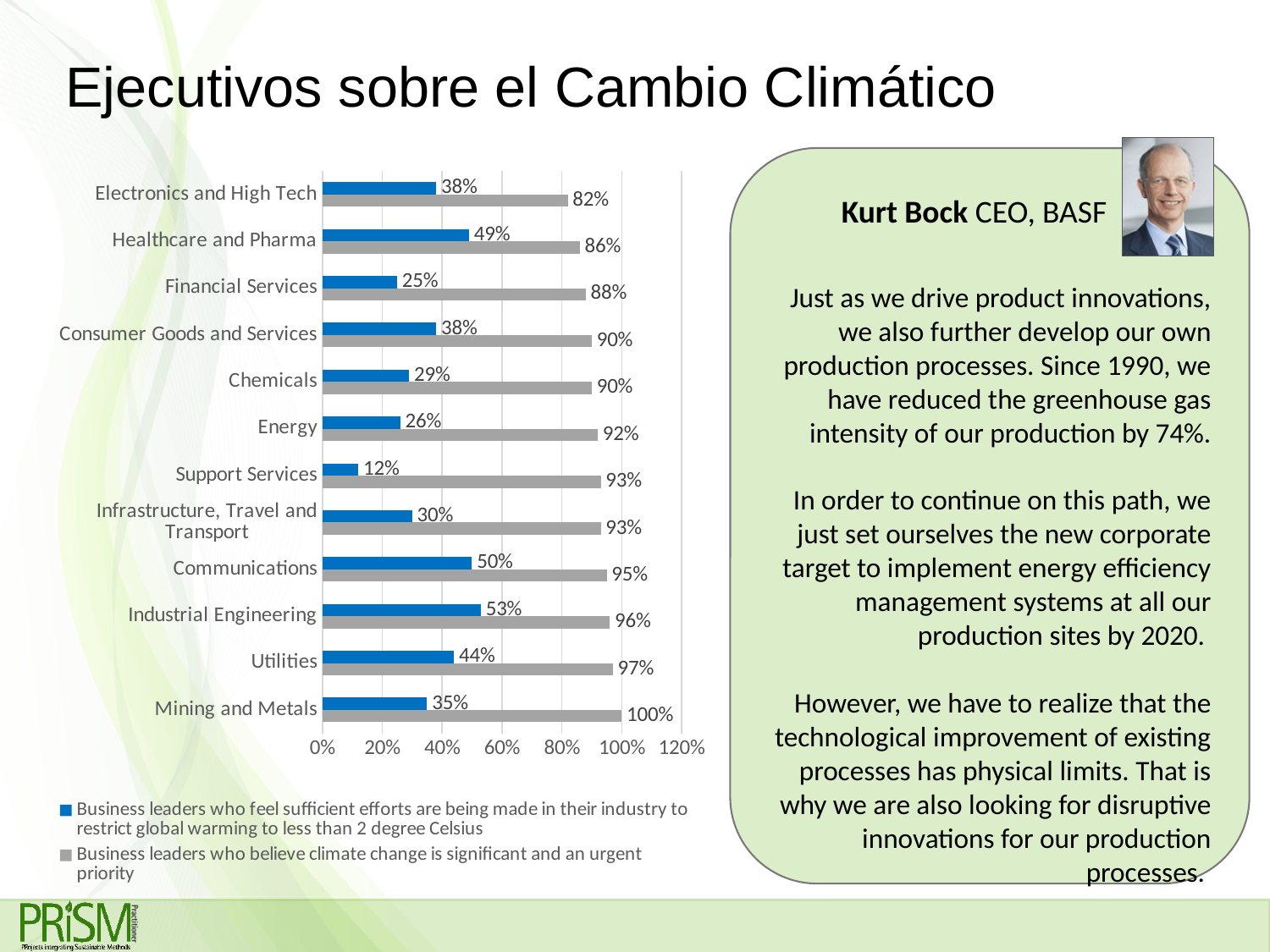
What is the difference between the Industrial Engineering and Communications values for business leaders who feel sufficient efforts are being made? 3% How many series does the chart legend list? 2 What percentage of business leaders in Support Services feel sufficient efforts are being made in their industry to restrict global warming to less than 2 degree Celsius? 12% What kind of chart is shown on the slide? bar chart Which is larger: the share of Utilities leaders who feel sufficient efforts are being made, or the share of Chemicals leaders who feel sufficient efforts are being made? Utilities What percentage of business leaders in Healthcare and Pharma feel sufficient efforts are being made in their industry? 49% How many industry categories are shown in the chart? 12 What is the difference between the share of Financial Services leaders who believe climate change is significant and an urgent priority and the share who feel sufficient efforts are being made? 63% Which industry has the highest share of business leaders who feel sufficient efforts are being made in their industry? Industrial Engineering What percentage of business leaders in Mining and Metals believe climate change is significant and an urgent priority? 100% Which colour represents business leaders who believe climate change is significant and an urgent priority? gray Which industry has the lowest share of business leaders who believe climate change is significant and an urgent priority? Electronics and High Tech